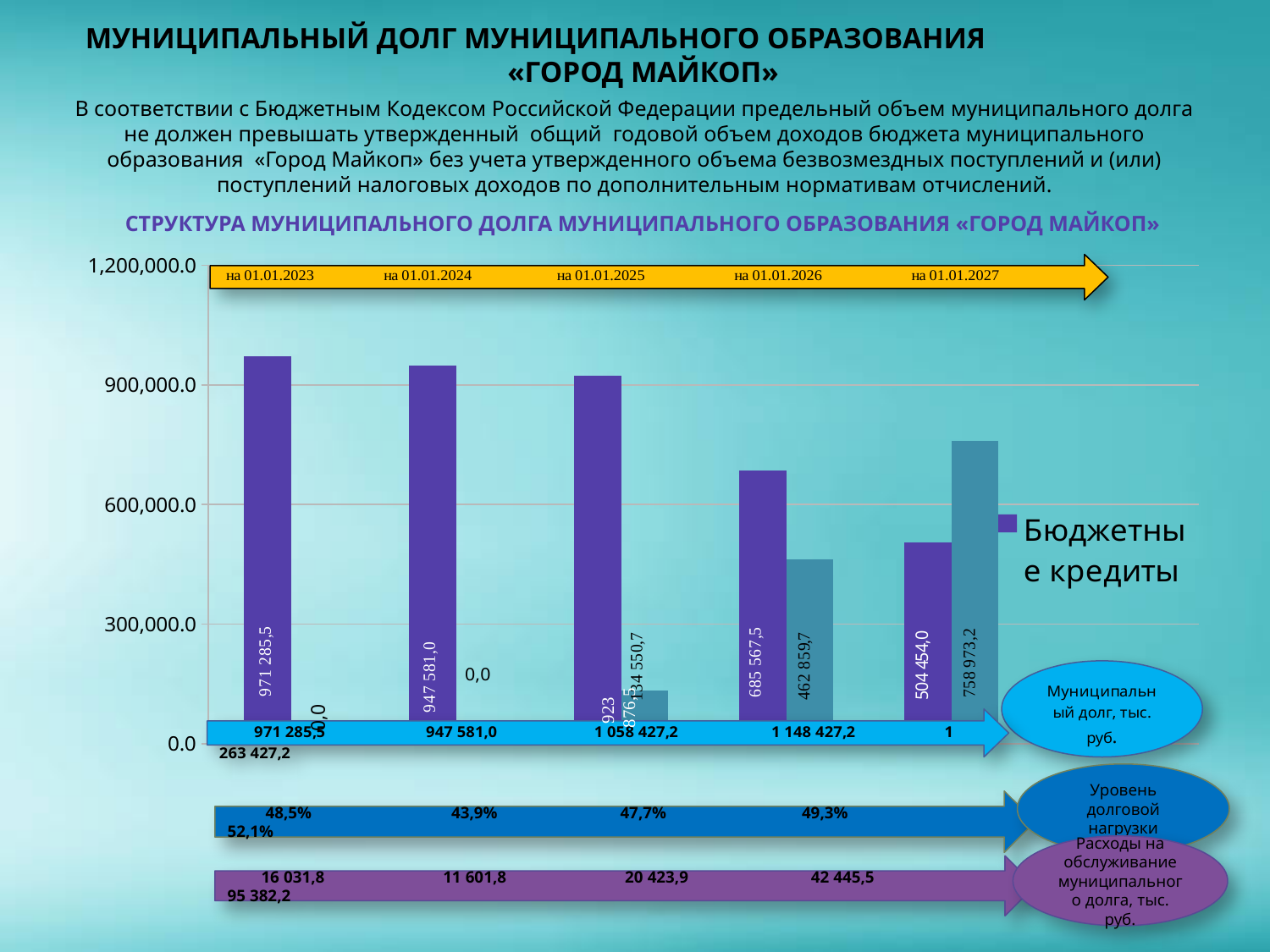
Do the values of Бюджетные кредиты rise or fall from 01.01.2023 to 01.01.2027? fall How many dates (categories) are shown along the x axis of the chart? 5 What is the value of Бюджетные кредиты на 01.01.2023? 971 285,5 On which date is the value of Бюджетные кредиты the highest? на 01.01.2023 Which series name is shown in the chart legend? Бюджетные кредиты What is the difference between the Бюджетные кредиты values на 01.01.2023 and на 01.01.2024? 23 704,5 What is the value of Бюджетные кредиты на 01.01.2027? 504 454,0 Is the value of Бюджетные кредиты на 01.01.2027 greater or less than 600,000.0? less Is the value of Бюджетные кредиты на 01.01.2026 greater or less than 600,000.0? greater What kind of chart is shown on the slide? bar chart What is the value of the light blue (second) bar на 01.01.2027? 758 973,2 On which date is the value of Бюджетные кредиты the lowest? на 01.01.2027